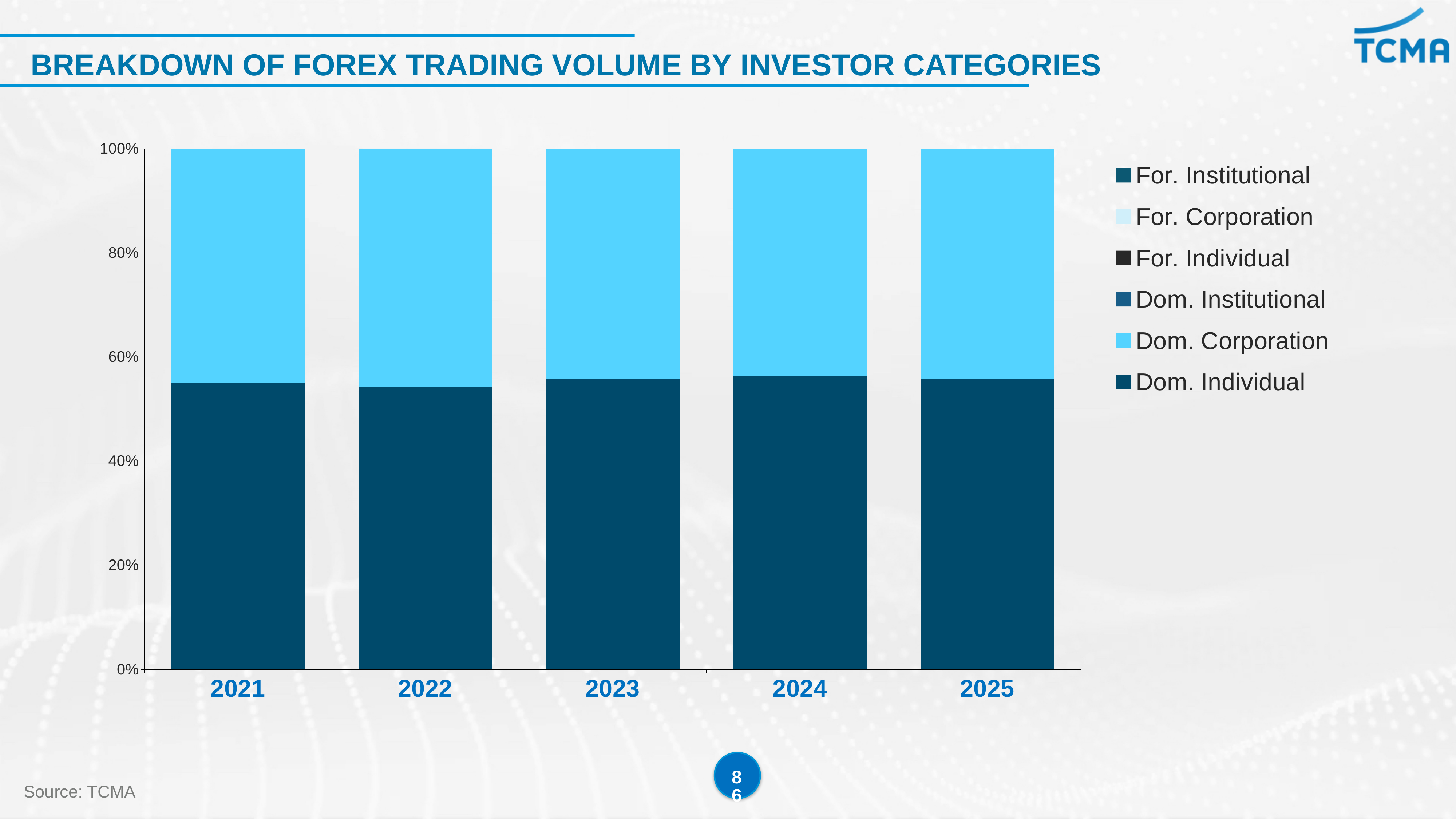
Is the Dom. Individual share in 2021 greater or less than 40%? greater In 2021, which is larger: the Dom. Individual share or the Dom. Corporation share? Dom. Individual What is the first year shown on the x axis? 2021 What is the title of the chart on the slide? Breakdown of Forex Trading Volume by Investor Categories Which legend entry is listed last in the chart's legend? Dom. Individual Is the Dom. Corporation share in 2023 greater or less than 50%? less How many series does the legend list? 6 What kind of chart is shown on the slide? Stacked bar chart Is the Dom. Individual share in 2022 greater or less than 60%? less How many years are shown on the x axis of the chart? 5